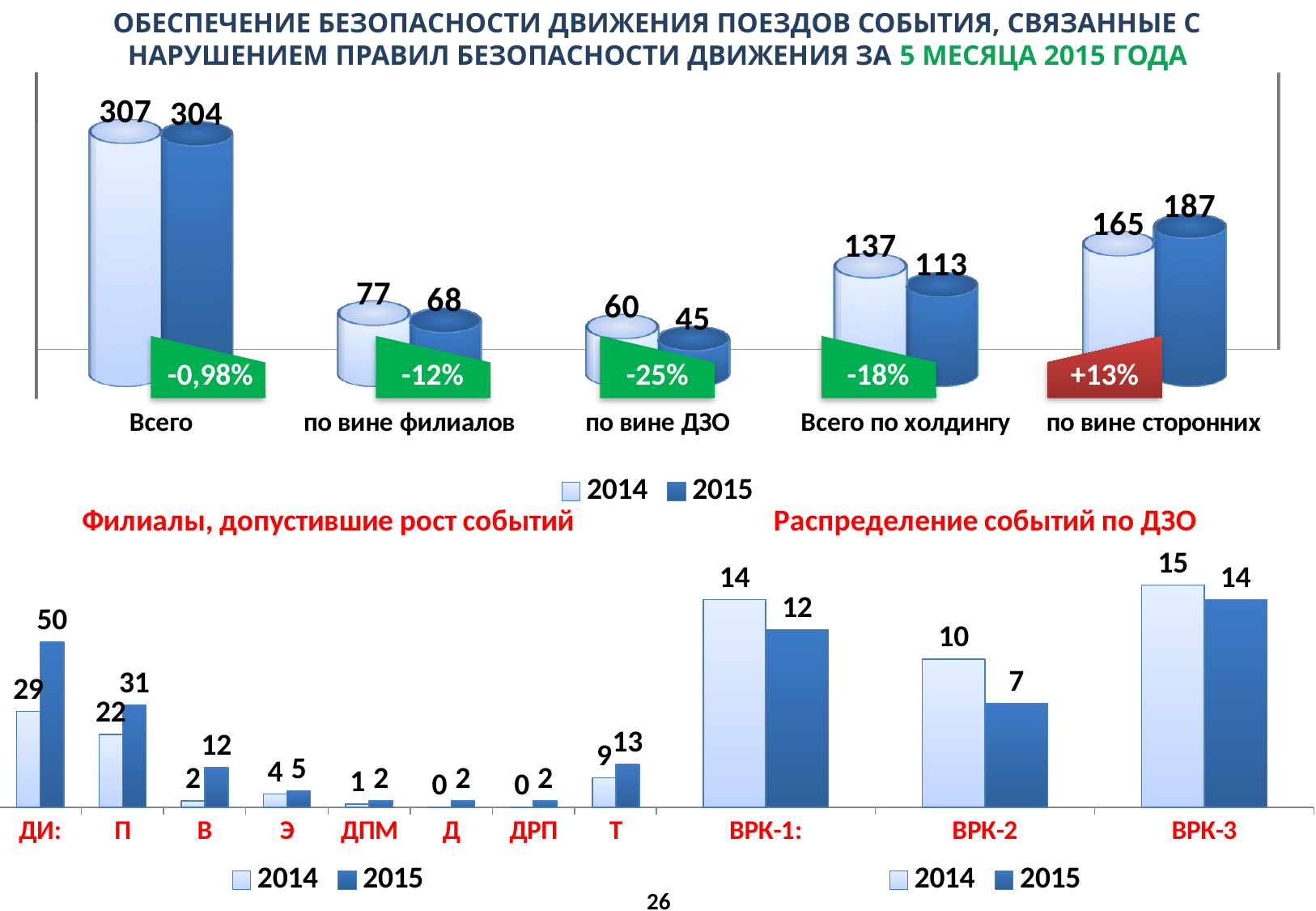
In the chart 'Филиалы, допустившие рост событий', which category has the highest 2015 value? ДИ: In the top chart, what is the 2015 value for 'Всего'? 304 In the chart 'Филиалы, допустившие рост событий', how many categories are shown on the x axis? 8 What kind of chart is 'Распределение событий по ДЗО'? bar chart In the top chart, how many series does the legend list? 2 In the chart 'Распределение событий по ДЗО', which is larger: the 2014 value for 'ВРК-1:' or the 2014 value for 'ВРК-3'? ВРК-3 In the chart 'Филиалы, допустившие рост событий', what is the 2015 value for 'ДИ:'? 50 In the top chart, what is the 2014 value for 'по вине ДЗО'? 60 In the chart 'Распределение событий по ДЗО', what is the 2015 value for 'ВРК-2'? 7 In the top chart, what percentage change is shown for 'по вине сторонних'? +13% In the top chart, what is the difference between the 2014 and 2015 values for 'Всего по холдингу'? 24 In the top chart, which category has the lowest 2015 value? по вине ДЗО